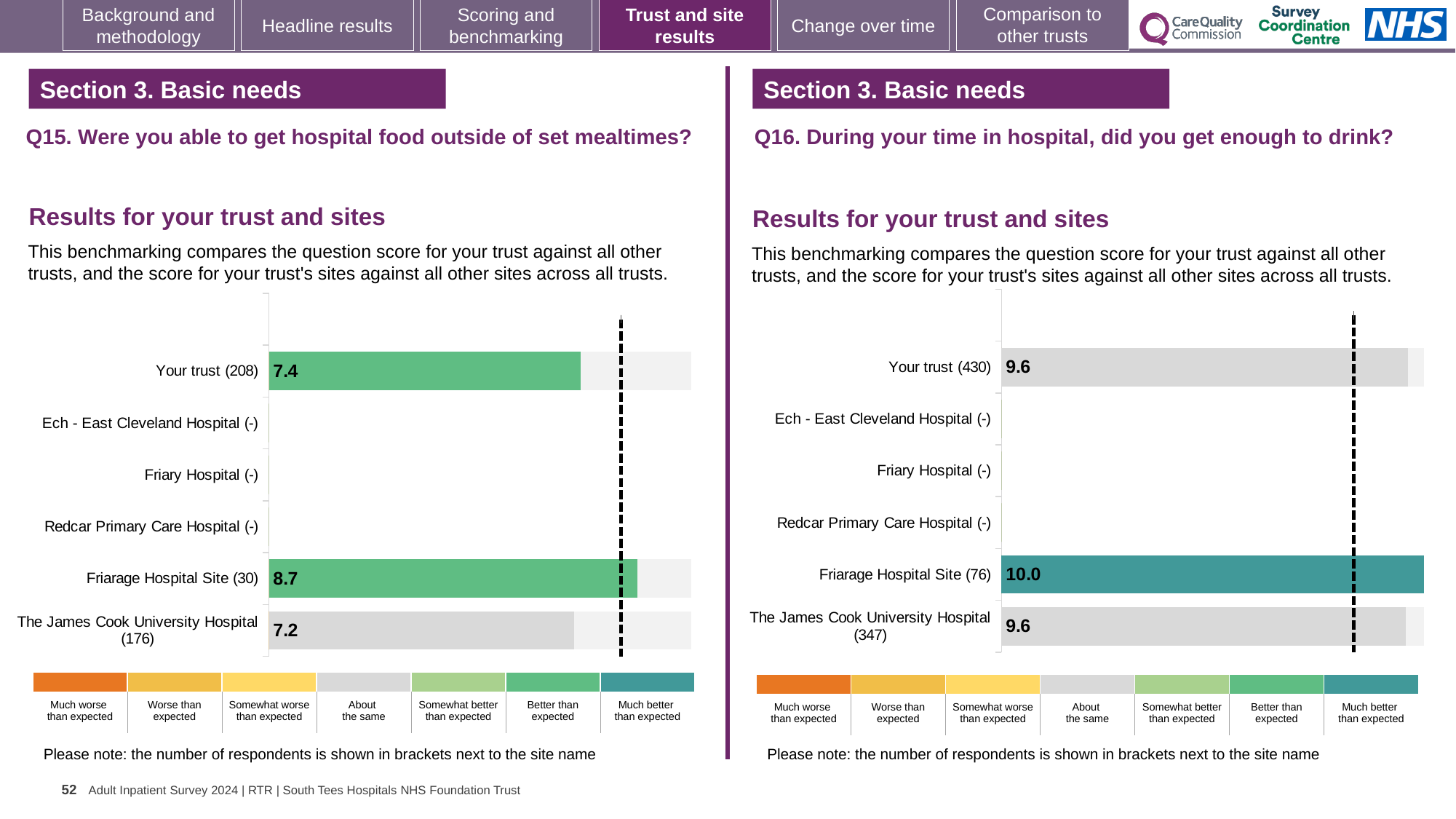
In the Q15 chart (left), what is the score for The James Cook University Hospital (176)? 7.2 In the Q15 chart (left), what is the difference between the Friarage Hospital Site score and The James Cook University Hospital score? 1.5 What kind of chart is used in the Q15 chart (left)? Bar chart In the Q16 chart (right), which site has the highest score? Friarage Hospital Site (76) In the Q16 chart (right), what is the score for Friarage Hospital Site (76)? 10.0 In the Q15 chart (left), which site has the highest score? Friarage Hospital Site (30) In the Q16 chart (right), what is the difference between the Friarage Hospital Site score and the Your trust score? 0.4 In the Q16 chart (right), what is the score for Your trust (430)? 9.6 In the Q15 chart (left), which is larger: the score for Your trust or the score for The James Cook University Hospital? Your trust In the Q15 chart (left), what is the score for Friarage Hospital Site (30)? 8.7 In the Q16 chart (right), what is the score for The James Cook University Hospital (347)? 9.6 In the Q15 chart (left), what is the score for Your trust (208)? 7.4